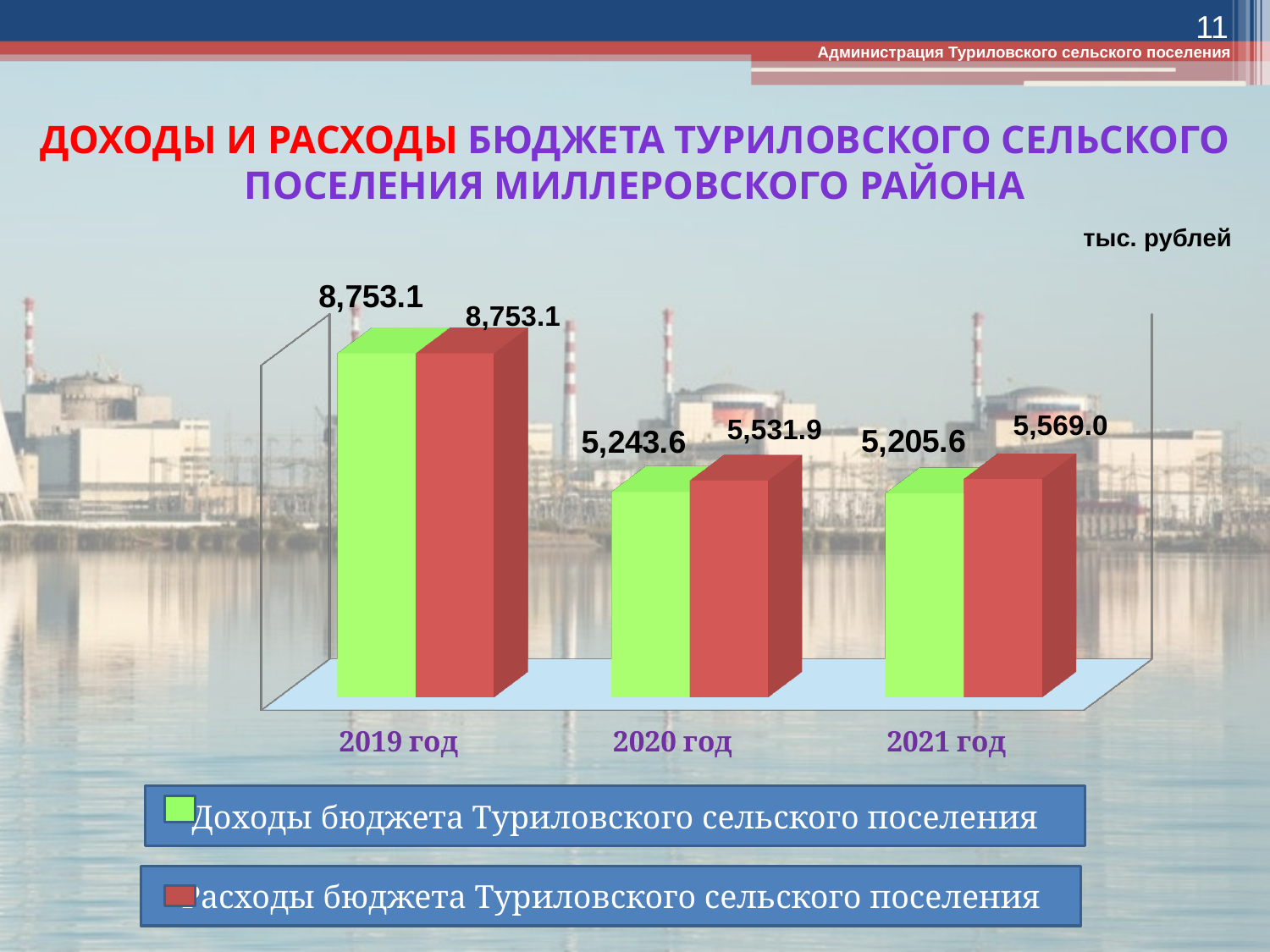
In which year is the value of Доходы бюджета Туриловского сельского поселения the lowest? 2021 год In which year is the value of Доходы бюджета Туриловского сельского поселения the highest? 2019 год What is the value of Расходы бюджета Туриловского сельского поселения for 2021 год? 5,569.0 Which is larger in 2021 год: Доходы or Расходы бюджета Туриловского сельского поселения? Расходы What is the value of Доходы бюджета Туриловского сельского поселения for 2019 год? 8,753.1 What is the value of Расходы бюджета Туриловского сельского поселения for 2020 год? 5,531.9 What is the value of Доходы бюджета Туриловского сельского поселения for 2021 год? 5,205.6 How many series does the legend list? 2 What kind of chart is shown on the slide? Bar chart How many years are shown on the x axis of the chart? 3 What is the difference between Расходы and Доходы for 2020 год? 288.3 What is the difference between Расходы and Доходы for 2021 год? 363.4